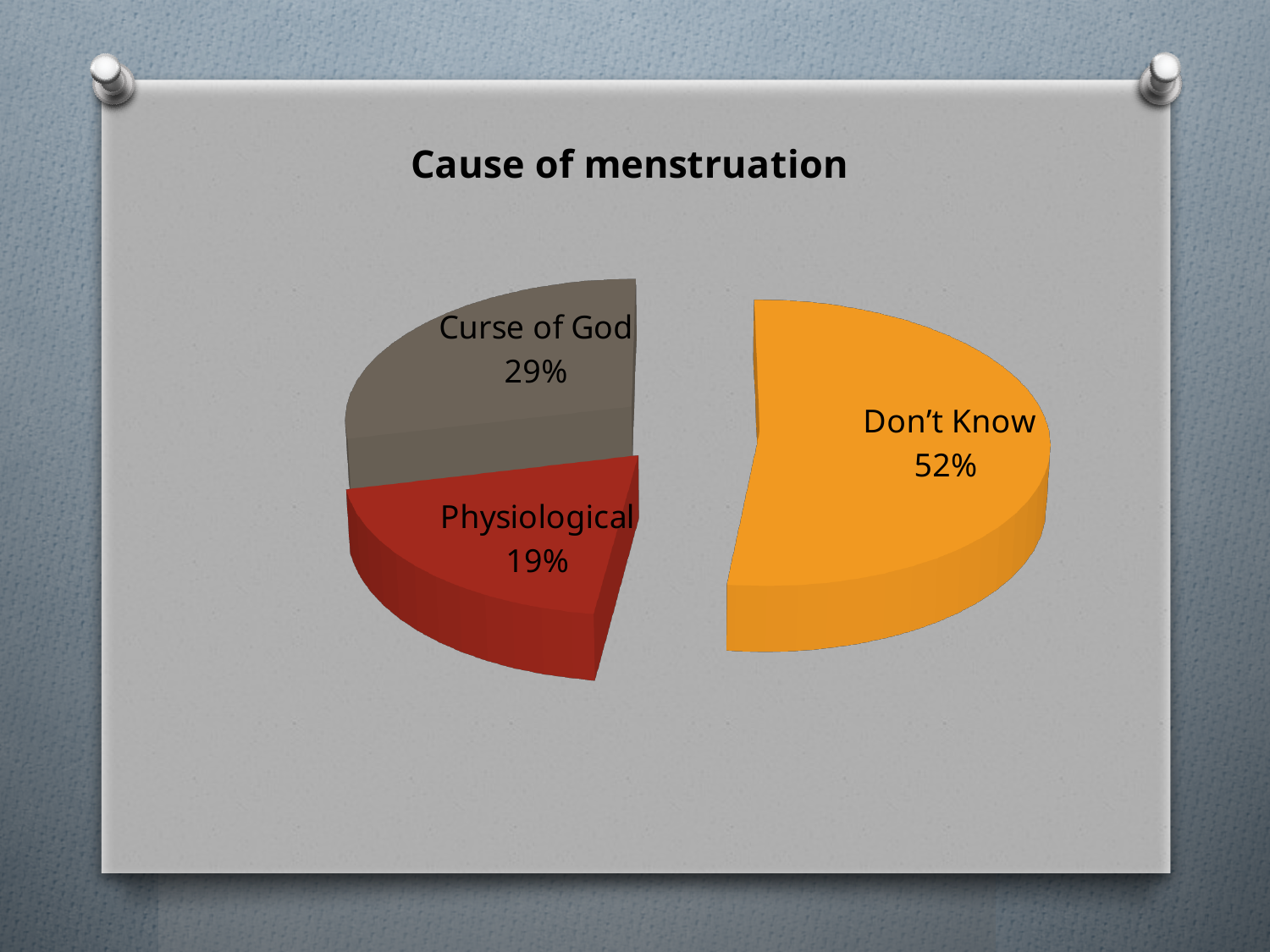
What kind of chart is shown on the slide? Pie chart What colour is the "Don't Know" slice? Orange What is the difference in percentage points between "Don't Know" and "Curse of God"? 23 How many slices does the pie chart have? 3 Which category has the smallest share of the pie? Physiological Which category has the largest share of the pie? Don't Know What percentage of respondents answered "Don't Know" for the cause of menstruation? 52% What share of the pie is labelled "Curse of God"? 29% What is the title of the chart? Cause of menstruation What is the difference in percentage points between "Curse of God" and "Physiological"? 10 Which is larger, the share for "Curse of God" or the share for "Physiological"? Curse of God What percentage is shown for the "Physiological" slice? 19%